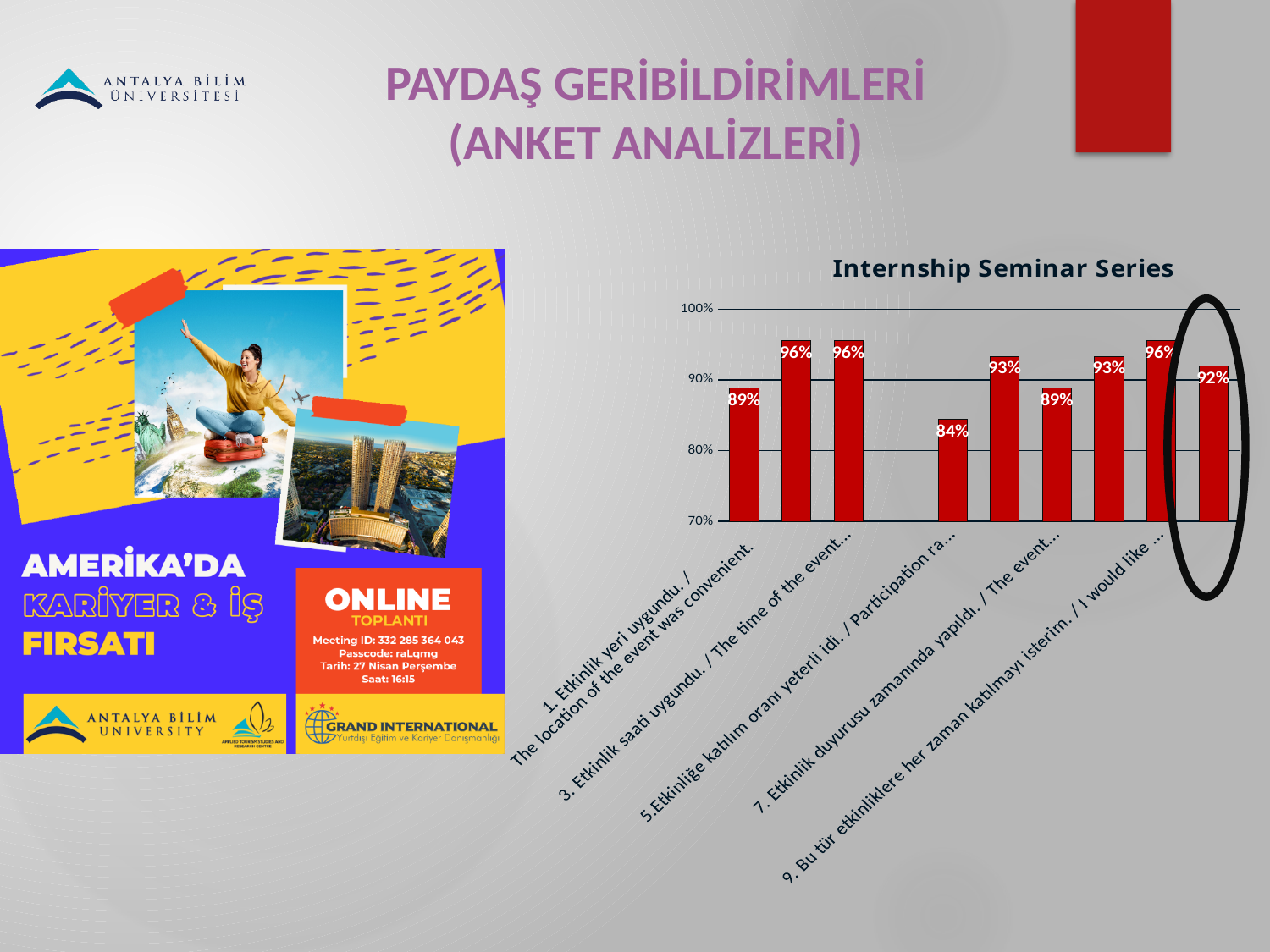
Is the value for item 5 'Participation ra...' greater or less than 90%? less What is the value for item 9, 'I would like ...' (to always attend such events)? 96% What is the value for item 3, 'The time of the event...'? 96% What is the lowest value shown in the chart? 84% What is the title of the chart on the slide? Internship Seminar Series What is the value for item 1, 'The location of the event was convenient'? 89% What kind of chart is shown on the slide? bar chart What is the value for item 5, 'Participation ra...'? 84% What is the difference between the value for item 9 (96%) and the value for item 5 (84%)? 12 percentage points What is the value for item 7, 'The event...' (announcement made on time)? 89% What is the highest value shown in the chart? 96% Which has the larger value: item 5 'Participation ra...' or item 7 'The event...'? item 7